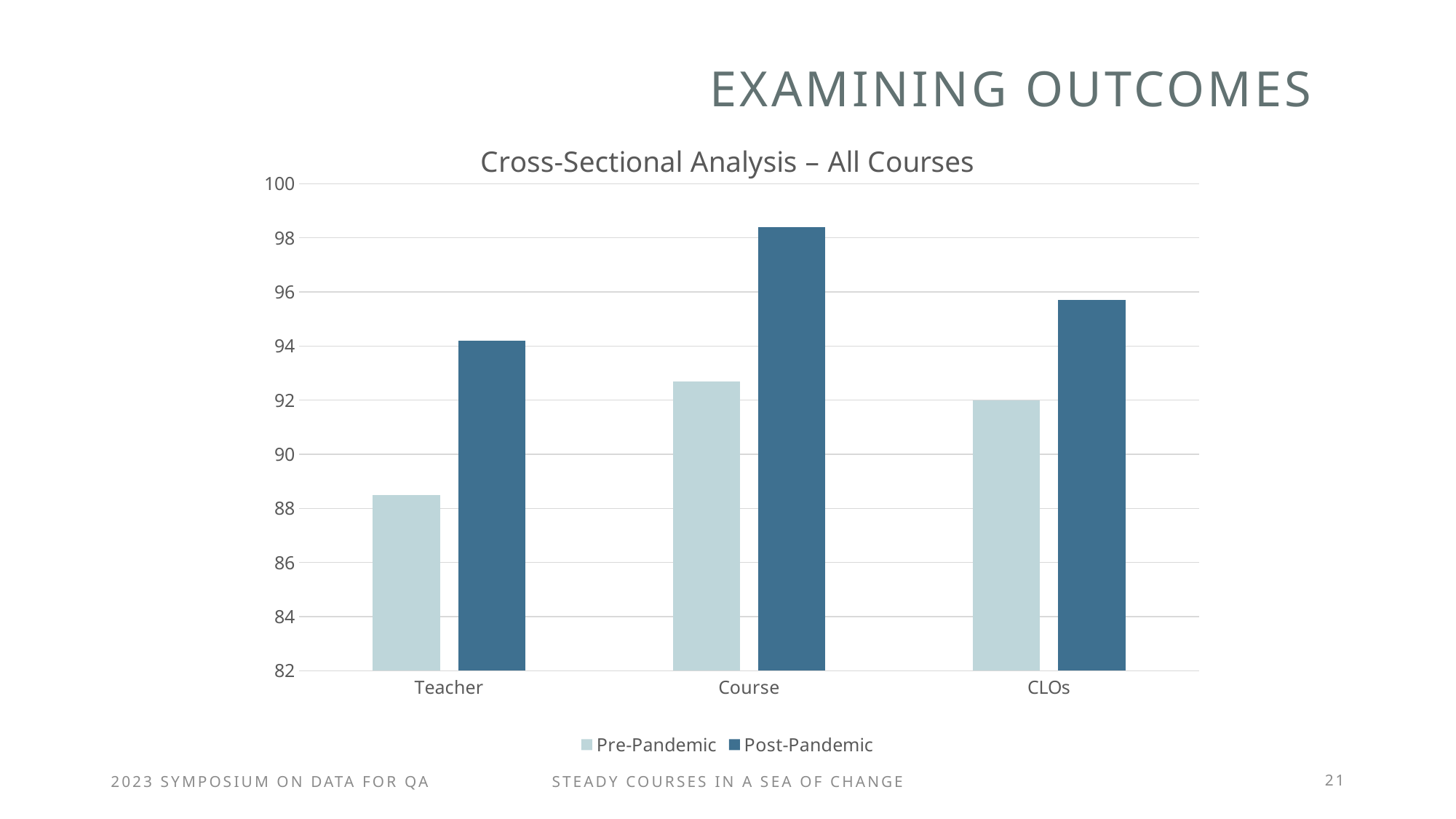
How many series does the legend list? 2 Which is larger: the Post-Pandemic value for Teacher or the Post-Pandemic value for CLOs? CLOs For Teacher, which is larger: the Pre-Pandemic or the Post-Pandemic value? Post-Pandemic Is the Post-Pandemic value for Course greater or less than 96? greater Which category has the lowest Pre-Pandemic value? Teacher Is the Pre-Pandemic value for Teacher greater or less than 90? less Is the Pre-Pandemic value for Course greater or less than 94? less Which category has the highest Post-Pandemic value? Course How many categories are shown on the x axis of the chart? 3 What is the title of the chart? Cross-Sectional Analysis – All Courses What kind of chart is shown on the slide? bar chart